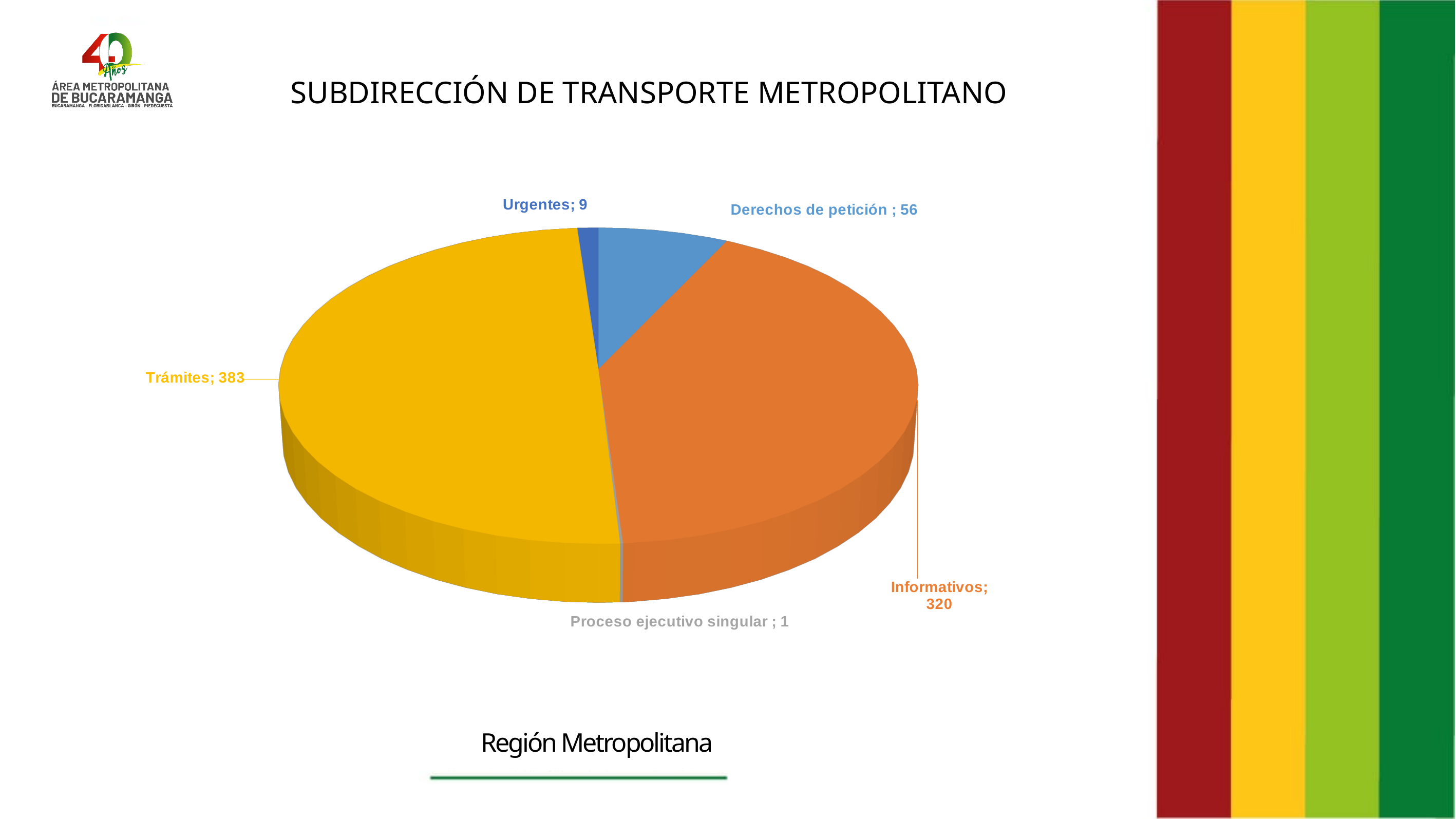
What is the value for Proceso ejecutivo singular? 1 Which is larger, the value for Derechos de petición or the value for Urgentes? Derechos de petición What is the value for Derechos de petición? 56 How many categories are shown in the pie chart? 5 What is the difference between the values for Trámites and Informativos? 63 What is the value for Informativos? 320 What is the value for Urgentes? 9 Which category has the largest slice of the pie? Trámites What is the value for Trámites? 383 What is the total of all the values shown in the pie chart? 769 Which category has the smallest slice of the pie? Proceso ejecutivo singular What kind of chart is shown on the slide? Pie chart